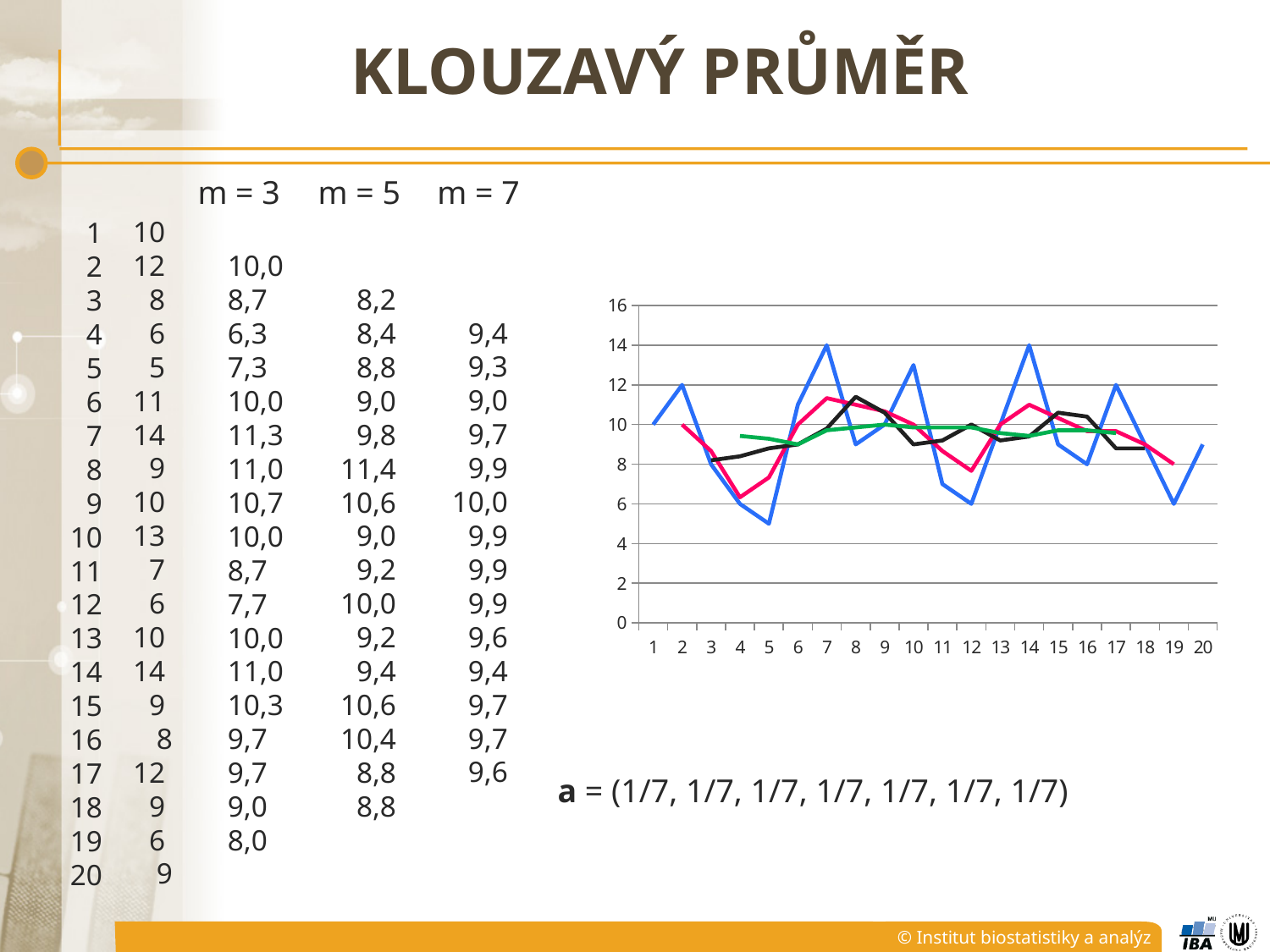
Is the value of the blue line at point 10 greater or less than 12? greater Is the value of the blue line at point 14 greater or less than 12? greater Is the value of the blue line at point 5 greater or less than 6? less How many points are labelled along the x axis of the chart? 20 What colour is the line with the largest swings (the raw data) on the chart? blue What is the value of the blue line at point 7? 14 How many lines are plotted on the chart? 4 At which x-axis point does the blue line reach its lowest value? 5 Does the blue line rise or fall from point 17 to point 19? fall What is the value of the blue line at point 12? 6 What kind of chart is shown on the slide? line chart Which is larger on the blue line: the value at point 7 or the value at point 8? point 7